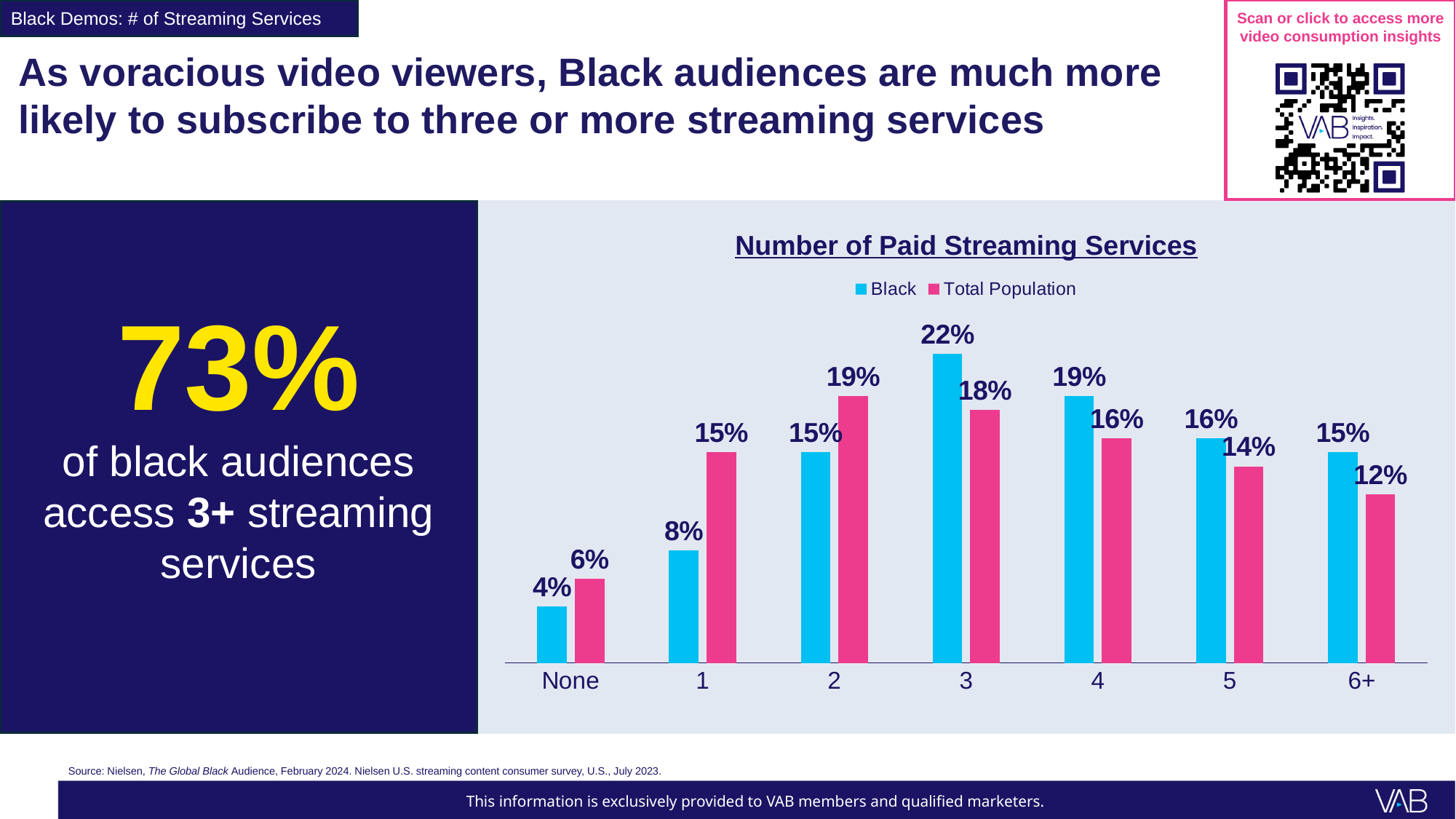
Which category has the lowest value for the Total Population series? None What is the value for Black audiences at 3 streaming services? 22% What is the title of the chart? Number of Paid Streaming Services How many categories are shown on the x axis? 7 What is the difference between Black and Total Population at 3 streaming services? 4% How many series does the legend list? 2 Which is larger at 6+ streaming services, Black or Total Population? Black Which is larger at 2 streaming services, Black or Total Population? Total Population What is the value for Total Population at 1 streaming service? 15% What is the value for Black audiences at None? 4% Which category has the highest value for the Black series? 3 What kind of chart is shown? Bar chart